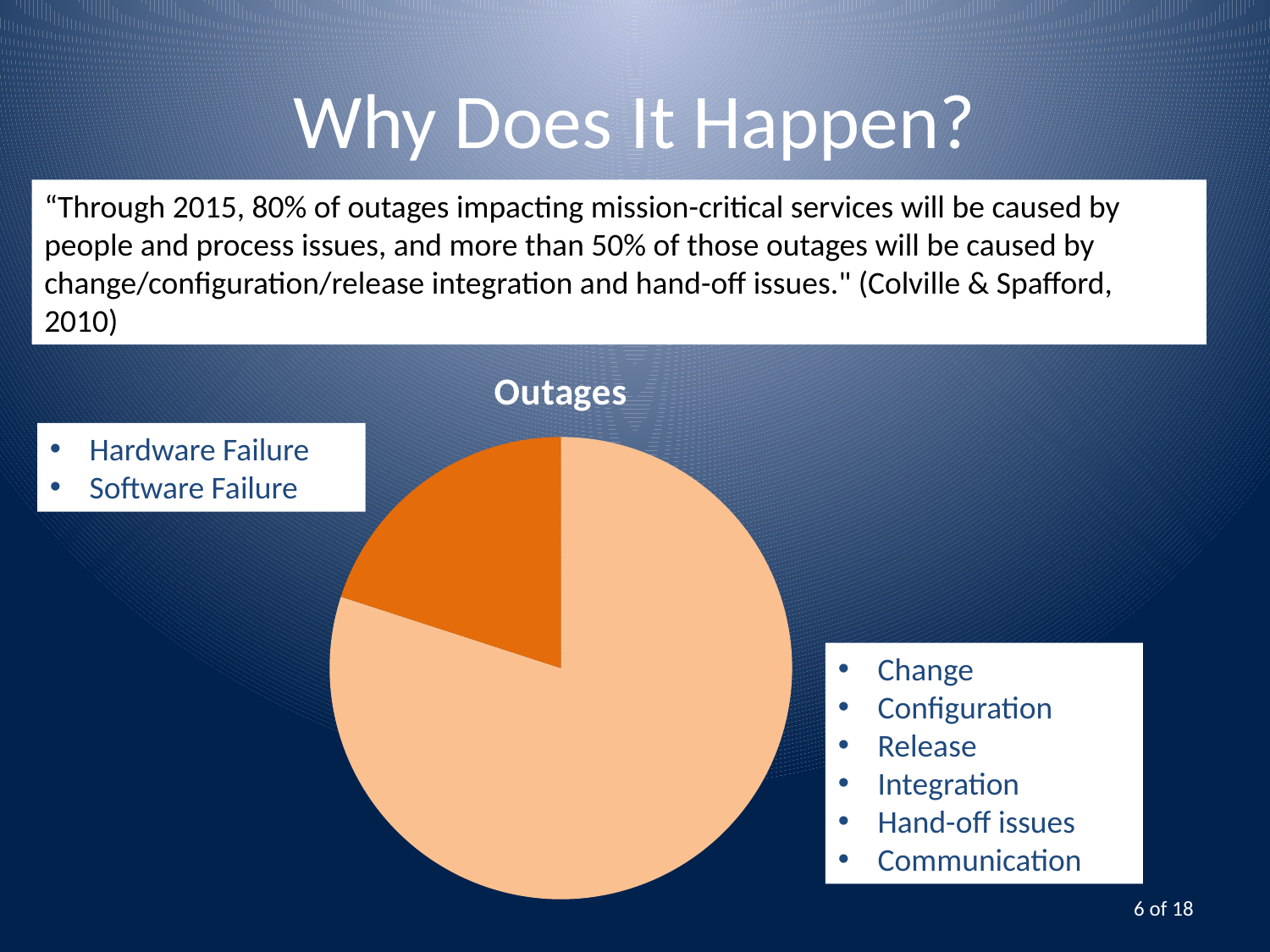
How many slices does the Outages pie chart have? 2 What is the title of the pie chart? Outages Which slice of the Outages pie chart is larger, the light orange slice or the dark orange slice? the light orange slice What kind of chart is shown on the slide? pie chart What colour is the smaller slice of the Outages pie chart? dark orange Does the larger slice of the Outages pie chart cover more or less than half of the pie? more Which slice of the Outages pie chart is the smallest? the dark orange slice